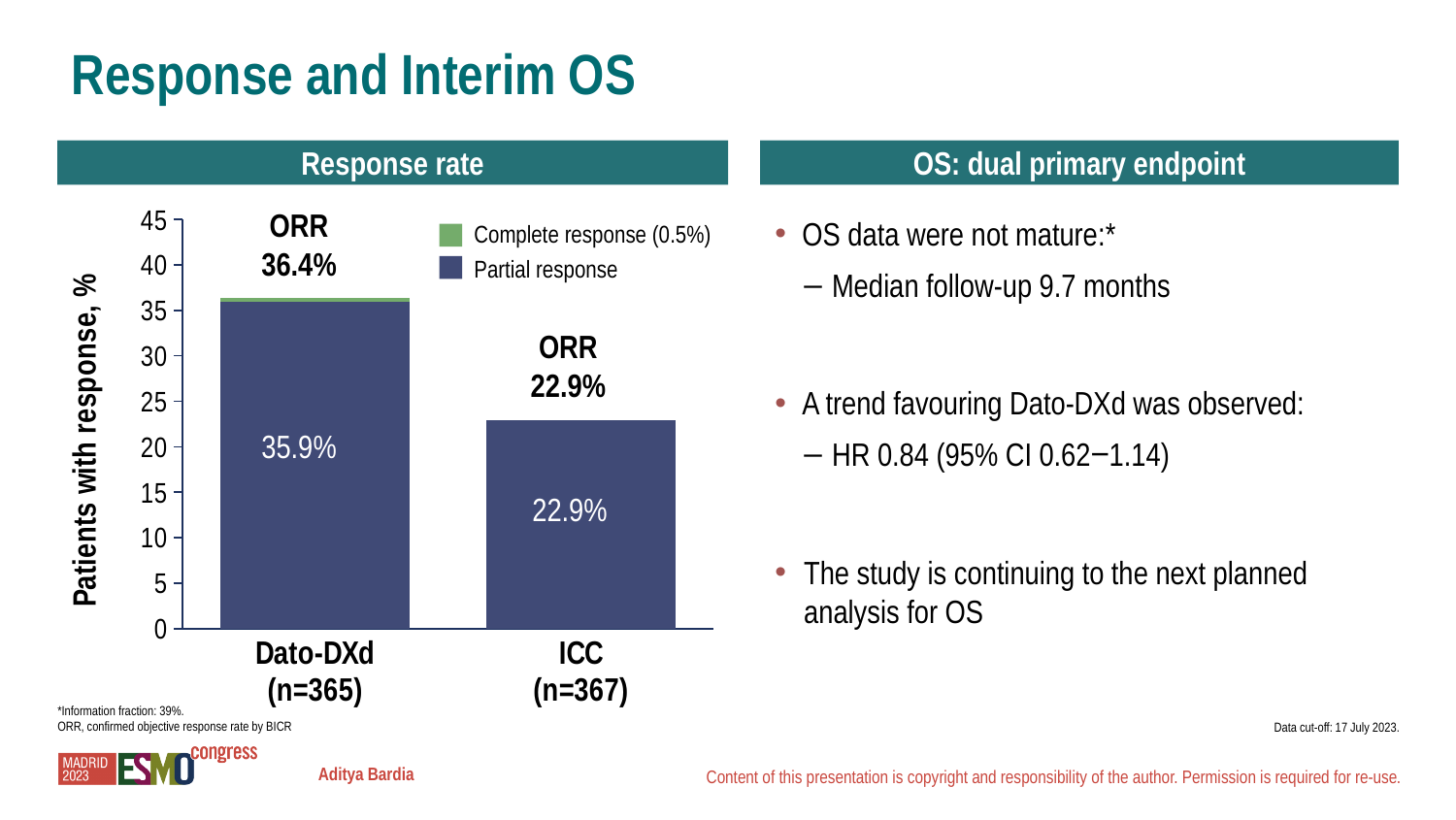
What is the ORR shown above the ICC bar? 22.9% Is the partial response rate for Dato-DXd greater or less than 30? greater What is the ORR shown above the Dato-DXd bar? 36.4% What kind of chart is used to show the response rate? Stacked bar chart How many response categories does the legend list? 2 How many treatment arms are shown on the x axis of the chart? 2 Which treatment arm has the higher ORR? Dato-DXd What is the complete response rate given in the legend? 0.5% What is the partial response rate for Dato-DXd (n=365)? 35.9% Which treatment arm has the lower partial response rate? ICC What is the difference in ORR between Dato-DXd and ICC? 13.5% What is the partial response rate for ICC (n=367)? 22.9%